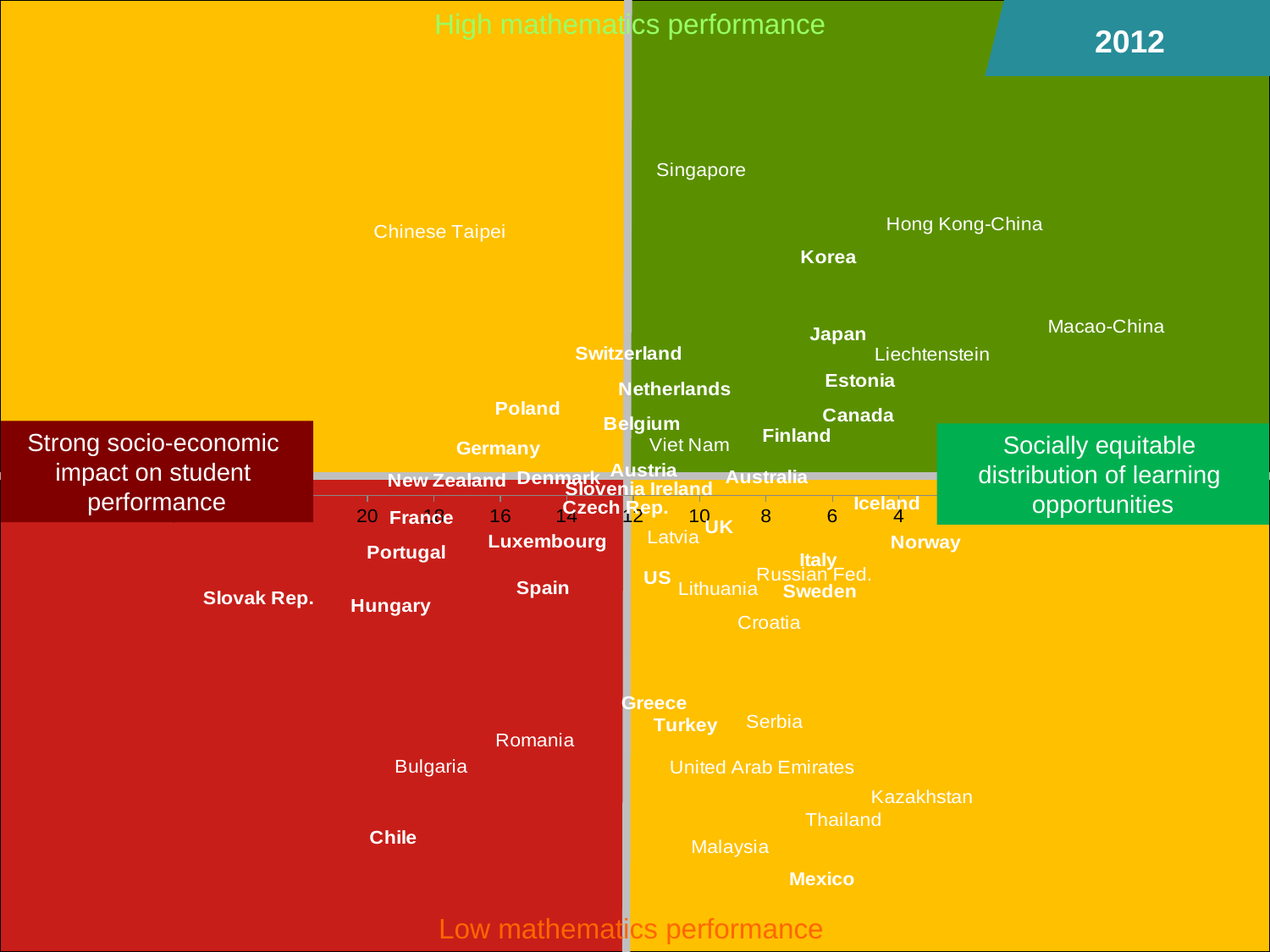
Is Chile plotted in the high or low mathematics performance half of the chart? Low mathematics performance Which is plotted higher on the vertical axis, Singapore or Mexico? Singapore What kind of chart is shown on the slide? scatter chart What label appears at the top of the chart above the vertical dividing line? High mathematics performance Is Singapore plotted in the high or low mathematics performance half of the chart? High mathematics performance Is the value for Slovak Rep. on the horizontal axis greater or less than 20? greater Is the value for Macao-China on the horizontal axis greater or less than 4? less Is the value for Poland on the horizontal axis greater or less than 12? greater What year is shown in the label at the top right of the chart? 2012